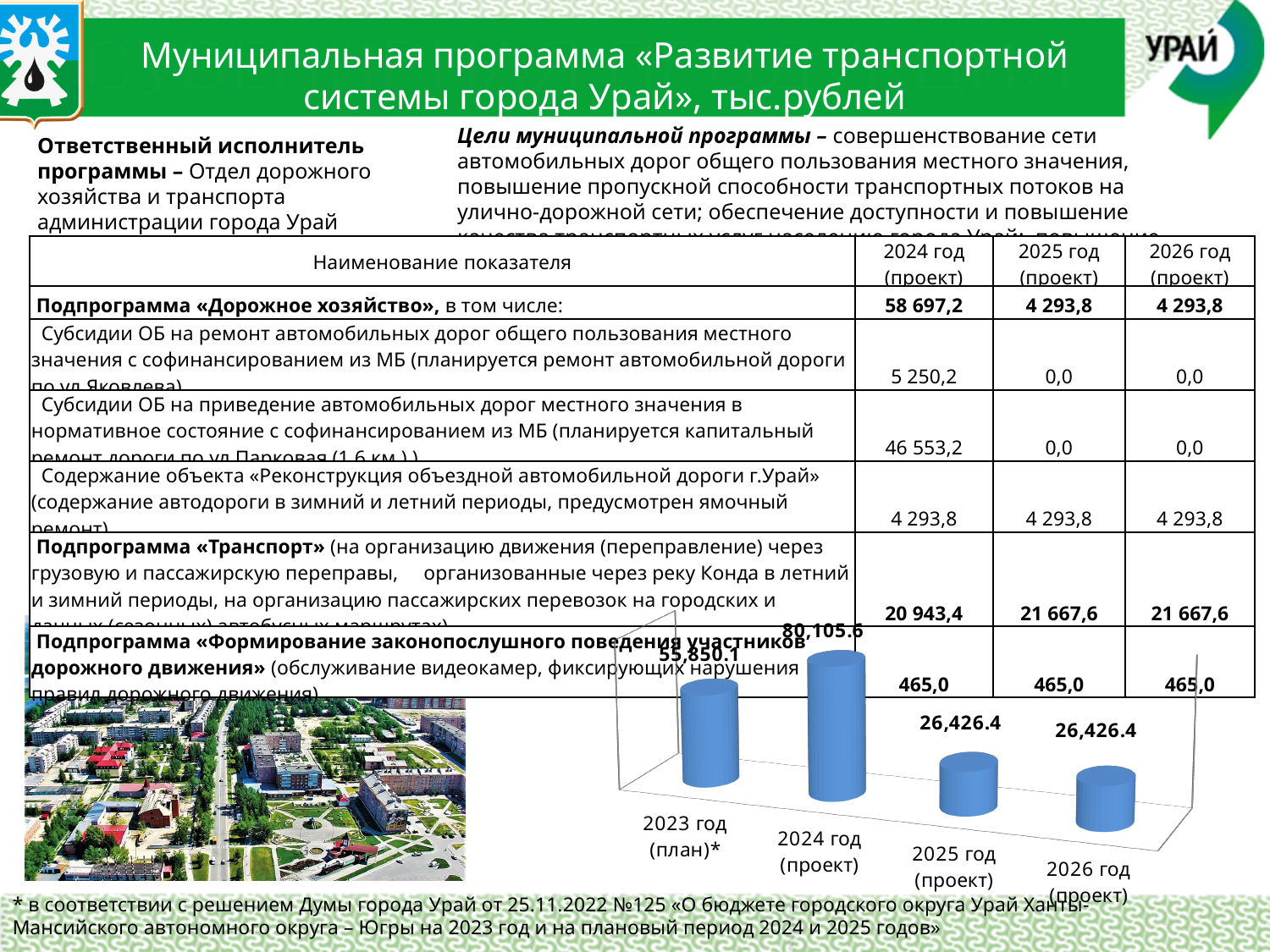
What colour are the bars in the chart? Blue Which year has the highest value in the chart? 2024 год (проект) Which is larger in the chart: the value for 2023 год (план)* or the value for 2025 год (проект)? 2023 год (план)* What kind of chart is shown on the slide? Bar chart What is the difference between the values for 2024 год (проект) and 2023 год (план)*? 24,255.5 What is the value shown for 2024 год (проект) in the chart? 80,105.6 What is the difference between the values for 2024 год (проект) and 2025 год (проект)? 53,679.2 How many categories (years) are plotted in the chart? 4 Do the values in the chart rise or fall from 2024 год (проект) to 2025 год (проект)? Fall What is the value shown for 2025 год (проект) in the chart? 26,426.4 What is the value shown for 2026 год (проект) in the chart? 26,426.4 What is the value shown for 2023 год (план)* in the chart? 55,850.1